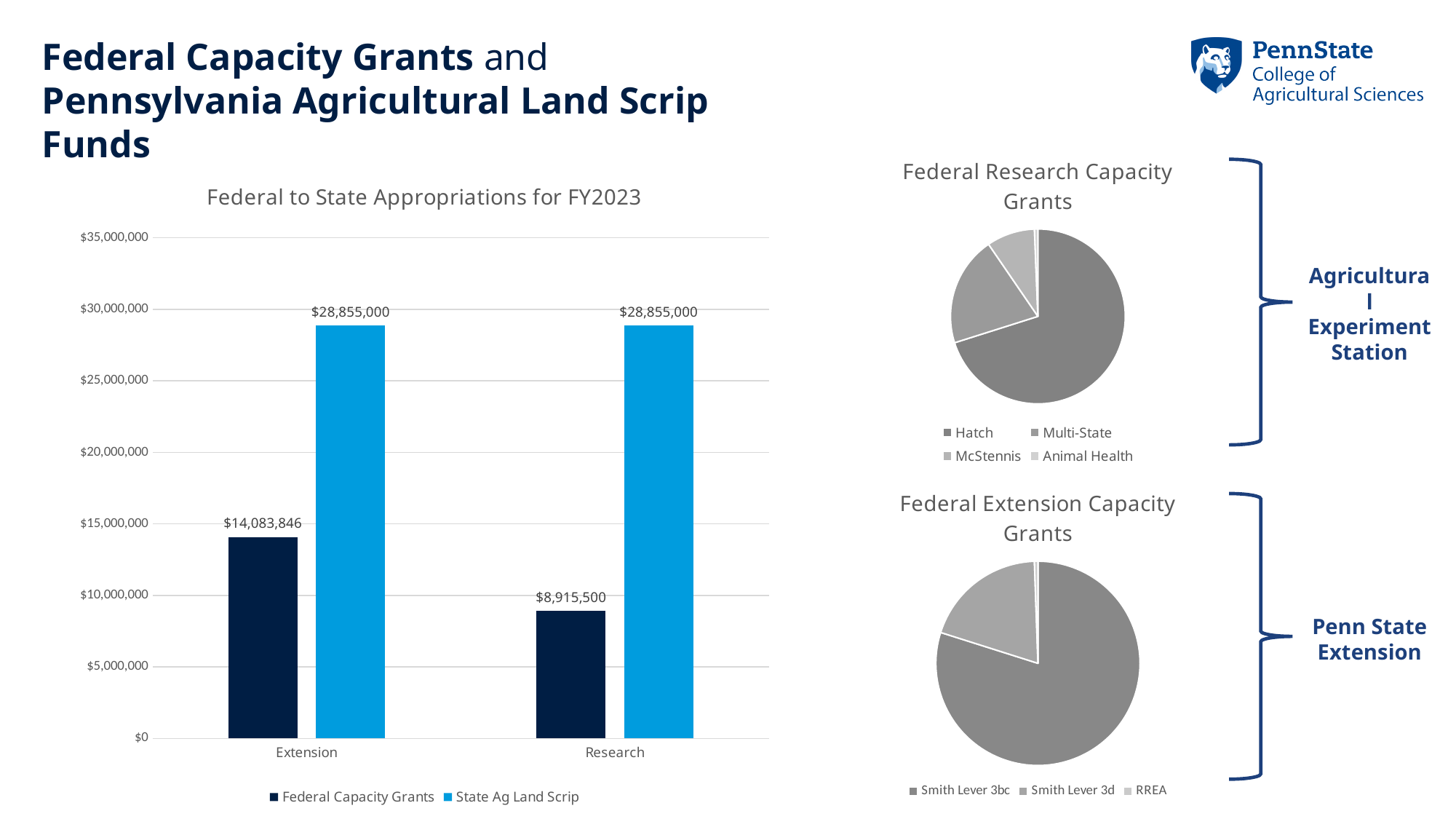
In the 'Federal to State Appropriations for FY2023' chart, what is the difference between the State Ag Land Scrip and Federal Capacity Grants values for Extension? $14,771,154 How many series does the legend of the 'Federal to State Appropriations for FY2023' chart list? 2 In the 'Federal to State Appropriations for FY2023' chart, which category has the higher Federal Capacity Grants value, Extension or Research? Extension In the 'Federal to State Appropriations for FY2023' chart, is the Federal Capacity Grants value for Research greater or less than $10,000,000? less In the 'Federal Extension Capacity Grants' pie chart, which category has the largest slice? Smith Lever 3bc In the 'Federal to State Appropriations for FY2023' chart, what is the value of Federal Capacity Grants for Research? $8,915,500 What kind of chart is 'Federal to State Appropriations for FY2023'? bar chart In the 'Federal Research Capacity Grants' pie chart, which category has the largest slice? Hatch In the 'Federal to State Appropriations for FY2023' chart, what is the value of Federal Capacity Grants for Extension? $14,083,846 In the 'Federal to State Appropriations for FY2023' chart, how much larger is the Federal Capacity Grants value for Extension than for Research? $5,168,346 How many categories does the legend of the 'Federal Research Capacity Grants' pie chart list? 4 In the 'Federal to State Appropriations for FY2023' chart, what is the State Ag Land Scrip value for Research? $28,855,000